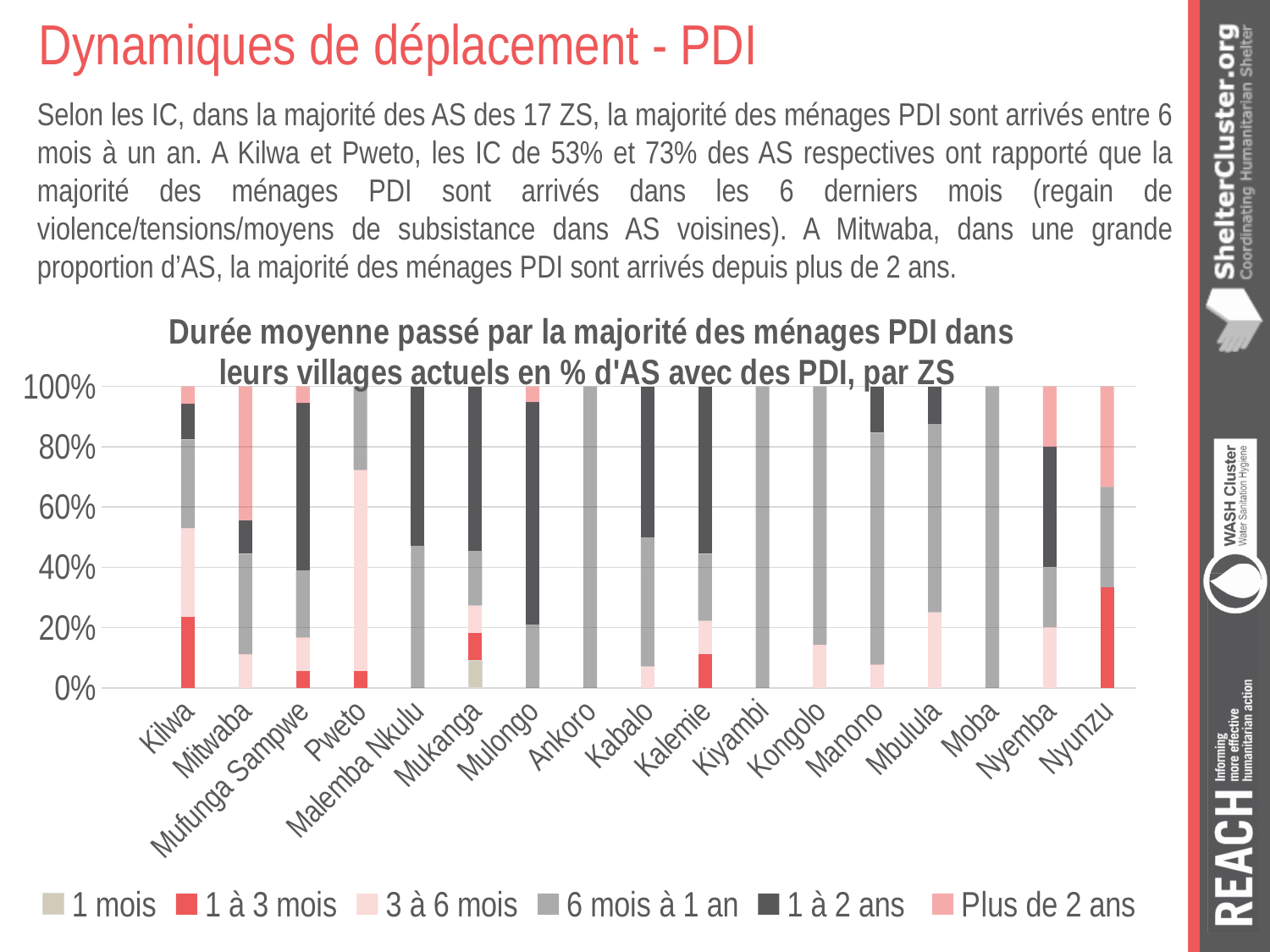
Is the value for '6 mois à 1 an' at Manono greater or less than 60%? greater Which single series makes up the entire bar for Ankoro? 6 mois à 1 an What is the title of the chart? Durée moyenne passé par la majorité des ménages PDI dans leurs villages actuels en % d'AS avec des PDI, par ZS Is the value for '6 mois à 1 an' at Kiyambi greater or less than 80%? greater How many ZS (categories) are shown along the x axis of the chart? 17 Which legend entry is shown in the darkest colour? 1 à 2 ans What kind of chart is shown on the slide? Stacked bar chart Is the value for '1 à 2 ans' at Mulongo greater or less than 60%? greater What is the total of the stacked bar for Kilwa? 100% How many series does the chart legend list? 6